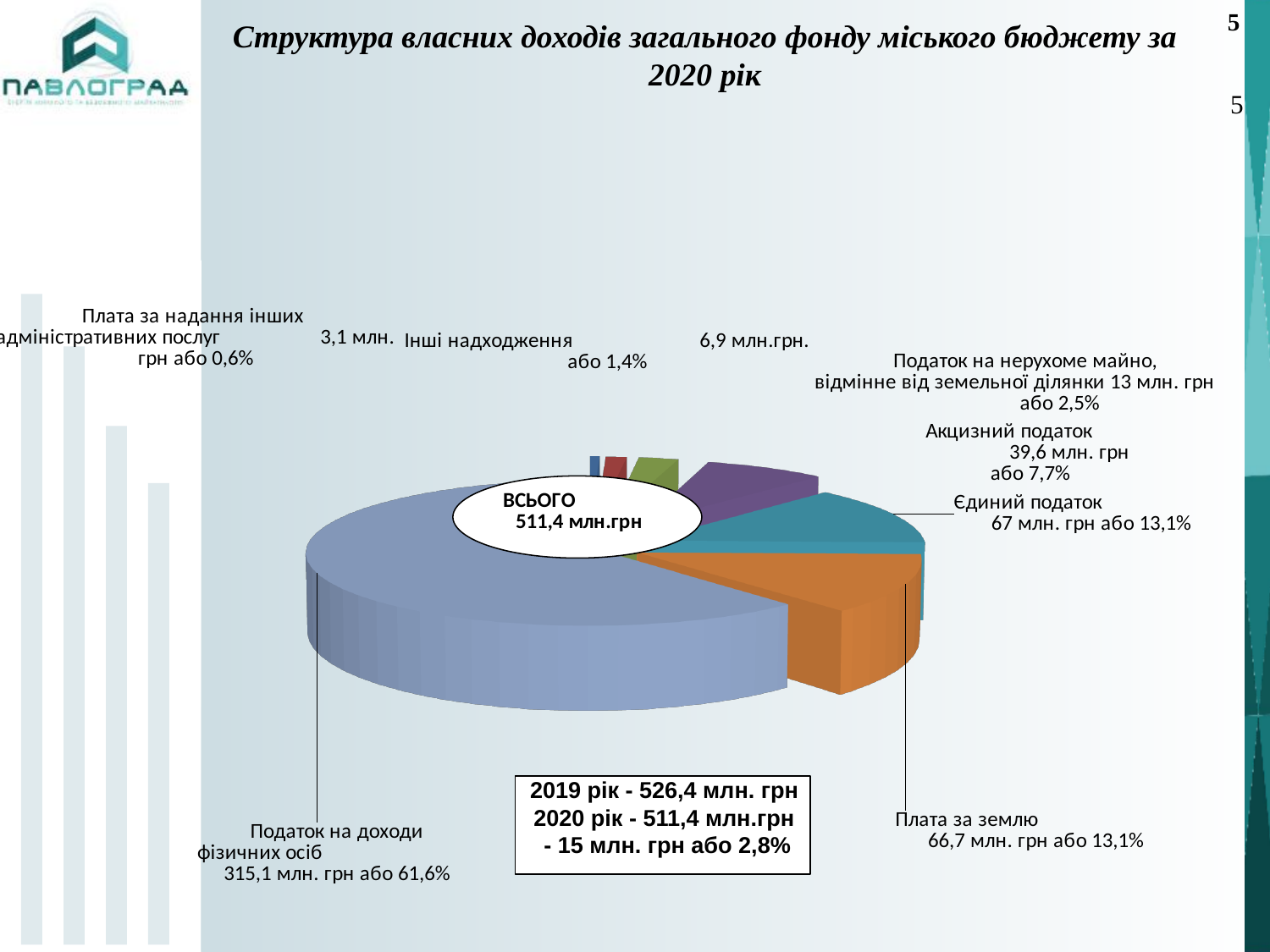
What share of the pie does Податок на доходи фізичних осіб represent? 61,6% What is the difference between Податок на доходи фізичних осіб and Плата за землю in млн. грн? 248,4 млн. грн How many slices does the pie chart have? 7 Which category has the largest slice of the pie? Податок на доходи фізичних осіб Which is larger, Плата за землю or Акцизний податок? Плата за землю What kind of chart is shown on the slide? pie chart Which category has the smallest slice of the pie? Плата за надання інших адміністративних послуг What is the value for Податок на доходи фізичних осіб? 315,1 млн. грн What is the value for Акцизний податок? 39,6 млн. грн What share of the pie does Плата за землю represent? 13,1% What is the title of the chart on the slide? Структура власних доходів загального фонду міського бюджету за 2020 рік What is the total value shown in the centre of the pie chart? 511,4 млн.грн